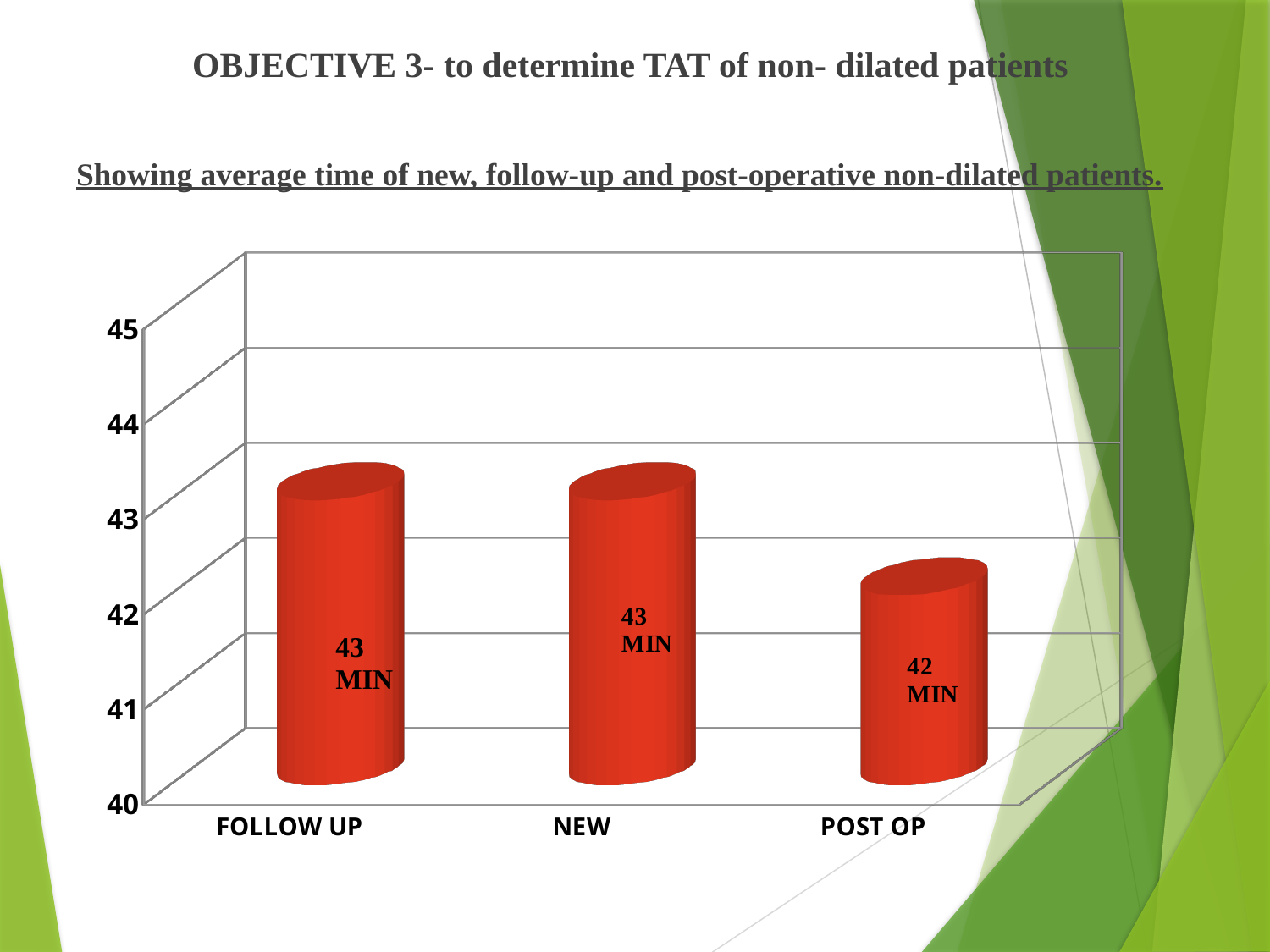
What is the average time shown for FOLLOW UP patients? 43 MIN What kind of chart is shown on the slide? bar chart What colour are the bars in the chart? red How many categories are shown on the x axis? 3 Do the values rise or fall from NEW to POST OP along the x axis? fall What is the difference between the average time for NEW and POST OP patients? 1 MIN What is the average time shown for POST OP patients? 42 MIN Which is larger, the value for FOLLOW UP or the value for POST OP? FOLLOW UP What is the average time shown for NEW patients? 43 MIN Which category has the lowest average time? POST OP What is the lowest value shown on the vertical axis? 40 Is the value for POST OP greater or less than 43? less